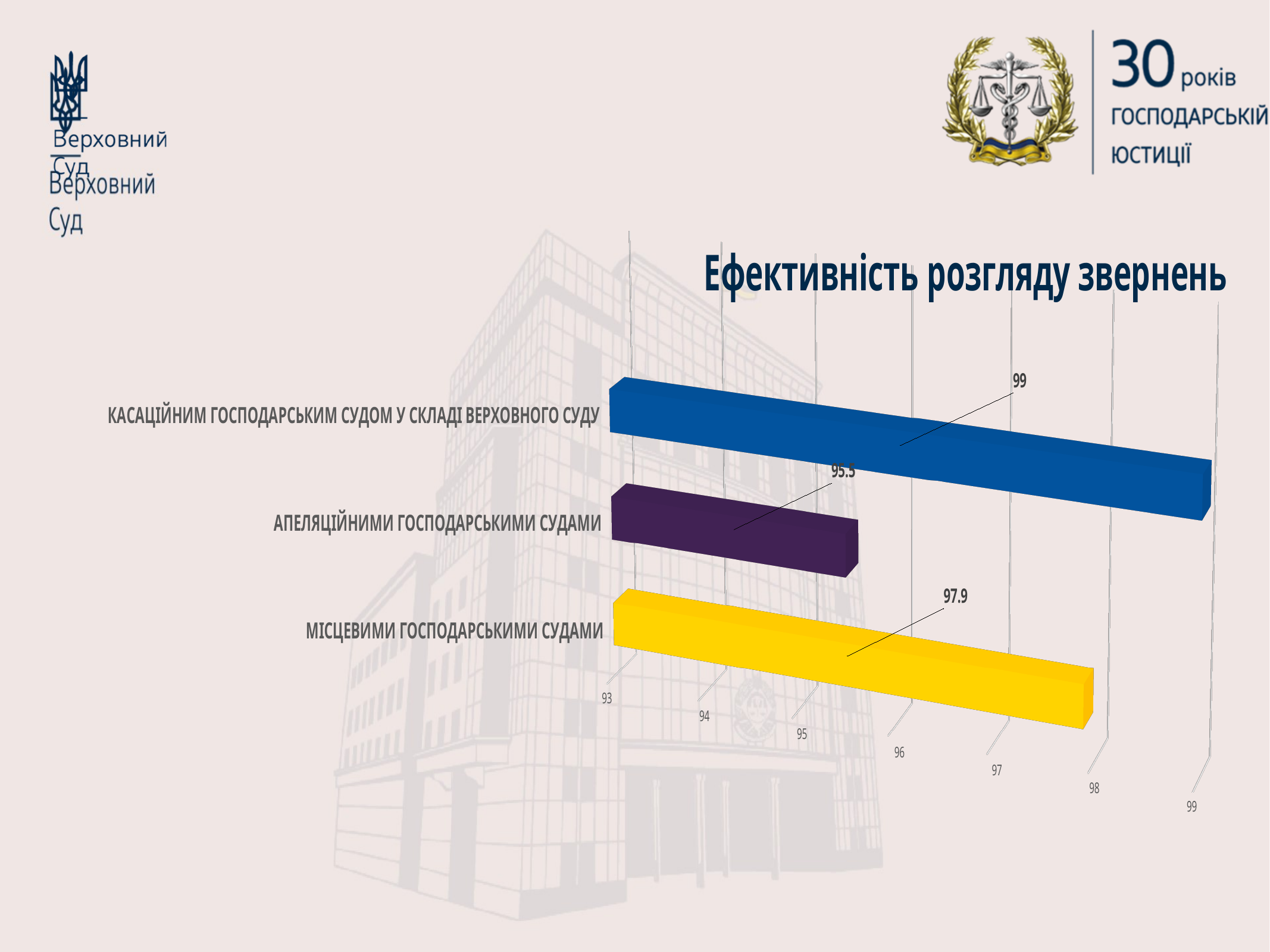
What is the value for МІСЦЕВИМИ ГОСПОДАРСЬКИМИ СУДАМИ? 97.9 How many categories are shown in the chart? 3 What is the title of the chart? Ефективність розгляду звернень What is the value for КАСАЦІЙНИМ ГОСПОДАРСЬКИМ СУДОМ У СКЛАДІ ВЕРХОВНОГО СУДУ? 99 What is the difference between the values for КАСАЦІЙНИМ ГОСПОДАРСЬКИМ СУДОМ У СКЛАДІ ВЕРХОВНОГО СУДУ and АПЕЛЯЦІЙНИМИ ГОСПОДАРСЬКИМИ СУДАМИ? 3.5 What kind of chart is shown on the slide? bar chart Which is larger: the value for МІСЦЕВИМИ ГОСПОДАРСЬКИМИ СУДАМИ or the value for АПЕЛЯЦІЙНИМИ ГОСПОДАРСЬКИМИ СУДАМИ? МІСЦЕВИМИ ГОСПОДАРСЬКИМИ СУДАМИ What is the value for АПЕЛЯЦІЙНИМИ ГОСПОДАРСЬКИМИ СУДАМИ? 95.5 What is the difference between the values for МІСЦЕВИМИ ГОСПОДАРСЬКИМИ СУДАМИ and АПЕЛЯЦІЙНИМИ ГОСПОДАРСЬКИМИ СУДАМИ? 2.4 Which category has the lowest value? АПЕЛЯЦІЙНИМИ ГОСПОДАРСЬКИМИ СУДАМИ Is the value for АПЕЛЯЦІЙНИМИ ГОСПОДАРСЬКИМИ СУДАМИ greater or less than 97? less Which category has the highest value? КАСАЦІЙНИМ ГОСПОДАРСЬКИМ СУДОМ У СКЛАДІ ВЕРХОВНОГО СУДУ